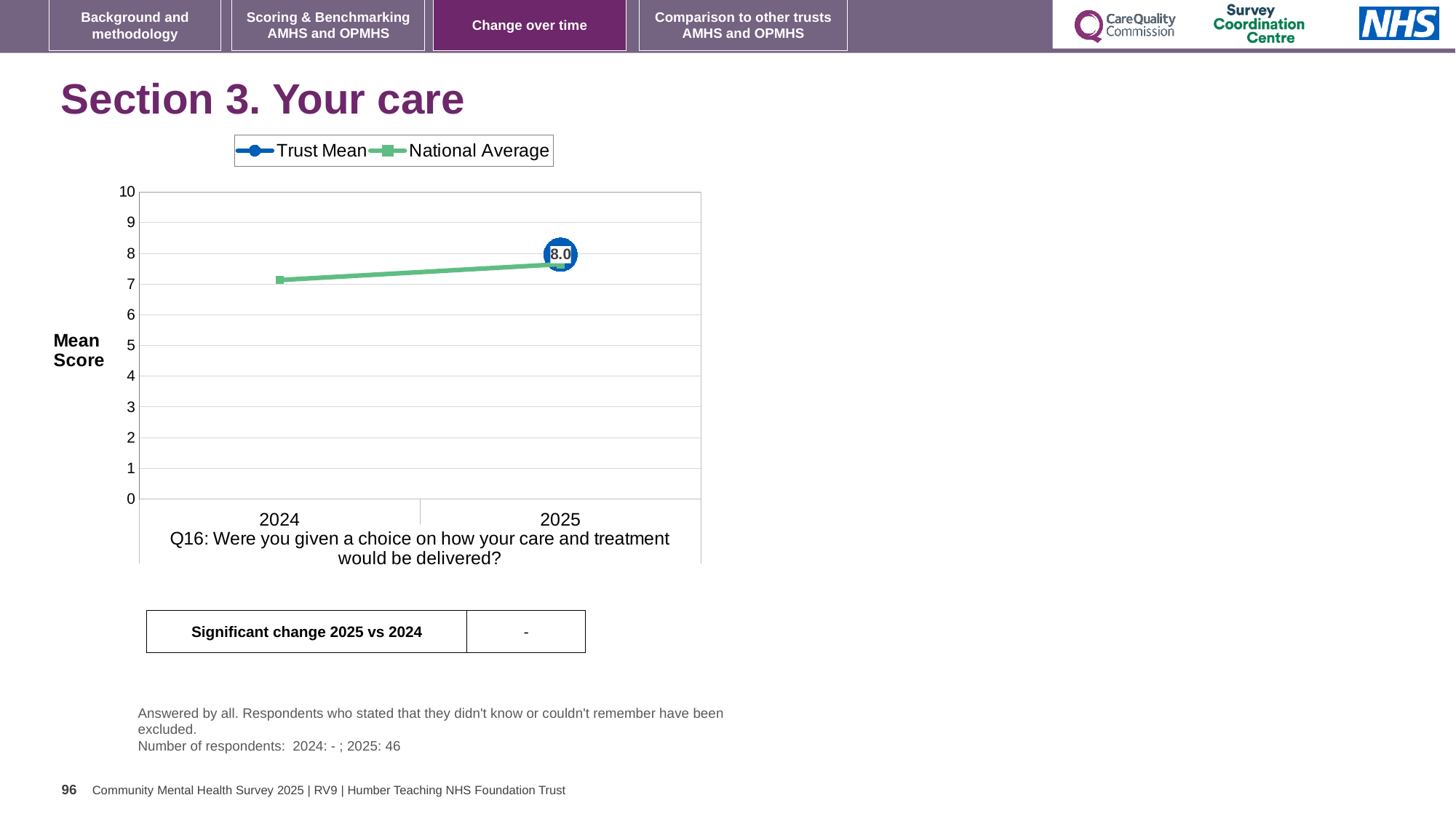
How many years are shown on the x axis? 2 Does the National Average rise or fall from 2024 to 2025? rise What kind of chart is shown on the slide? line chart What is the Trust Mean value for 2025? 8.0 What is the label on the y axis? Mean Score How many series does the legend list? 2 Is the National Average value for 2025 greater or less than 8? less Which series is shown in green? National Average In 2025, which is higher: the Trust Mean or the National Average? Trust Mean Is the National Average value for 2025 greater or less than 7? greater What is the highest value shown on the y axis? 10 Is the National Average value for 2024 greater or less than 8? less